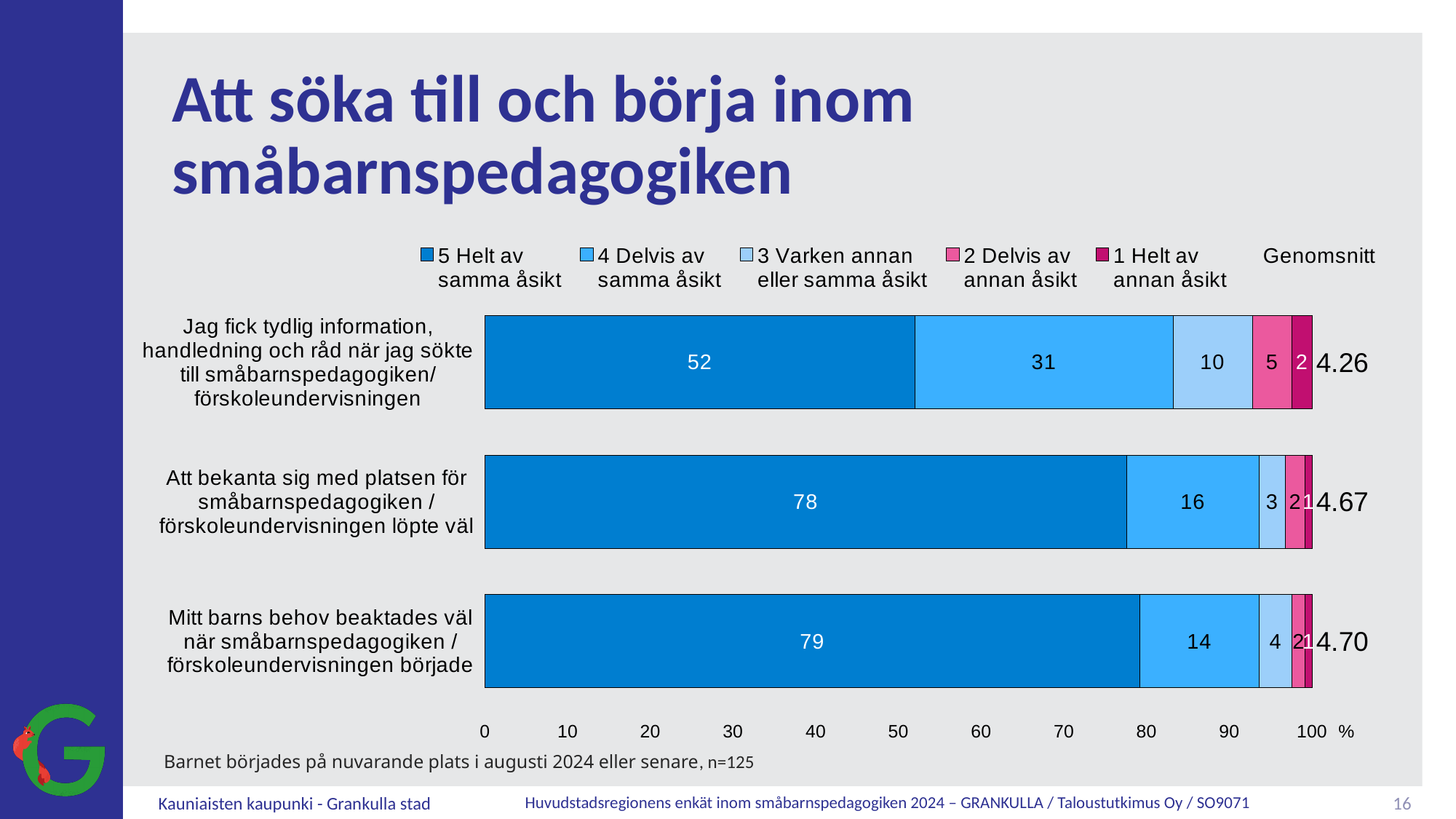
How many response categories (colored series) does the legend list? 5 What is the difference in the '5 Helt av samma åsikt' share between 'Att bekanta sig med platsen...' (78) and 'Jag fick tydlig information...' (52)? 26 Which statement has the highest share of '5 Helt av samma åsikt' responses? Mitt barns behov beaktades väl när småbarnspedagogiken / förskoleundervisningen började What is the combined share of '5 Helt av samma åsikt' and '4 Delvis av samma åsikt' for 'Mitt barns behov beaktades väl när småbarnspedagogiken / förskoleundervisningen började'? 93 How many statements (categories) are plotted in the chart? 3 What is the Genomsnitt (average) value for 'Mitt barns behov beaktades väl när småbarnspedagogiken / förskoleundervisningen började'? 4.70 Which statement has the lowest Genomsnitt (average) value? Jag fick tydlig information, handledning och råd när jag sökte till småbarnspedagogiken/förskoleundervisningen What type of chart is shown on the slide? Stacked bar chart What is the sample size (n) stated below the chart? n=125 What percentage answered '4 Delvis av samma åsikt' for 'Att bekanta sig med platsen för småbarnspedagogiken / förskoleundervisningen löpte väl'? 16 What percentage of respondents answered '5 Helt av samma åsikt' for 'Jag fick tydlig information, handledning och råd när jag sökte till småbarnspedagogiken/förskoleundervisningen'? 52 Which statement has a larger share of '3 Varken annan eller samma åsikt' responses: 'Jag fick tydlig information...' or 'Mitt barns behov beaktades väl...'? Jag fick tydlig information, handledning och råd när jag sökte till småbarnspedagogiken/förskoleundervisningen